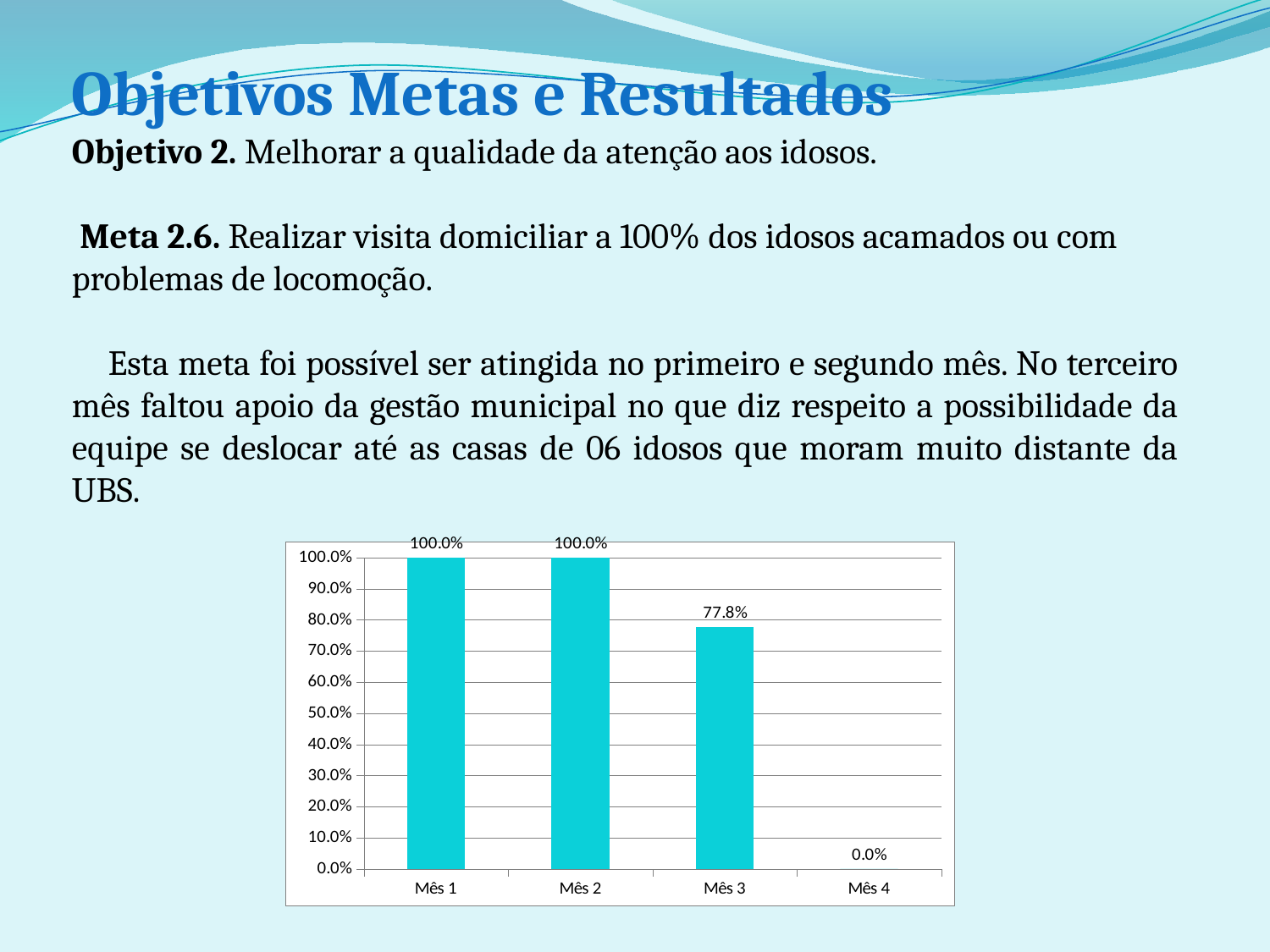
What kind of chart is shown on the slide? bar chart Is the value for Mês 3 greater or less than 70.0%? greater What colour are the bars in the chart? cyan What is the value for Mês 4? 0.0% What is the value for Mês 3? 77.8% What is the highest value shown on the y axis? 100.0% Which category has the lowest value? Mês 4 Which is larger, the value for Mês 1 or the value for Mês 3? Mês 1 What is the difference between the values for Mês 2 and Mês 3? 22.2% Do the values rise or fall from Mês 2 to Mês 4? fall How many categories are shown on the x axis? 4 What is the value for Mês 1? 100.0%